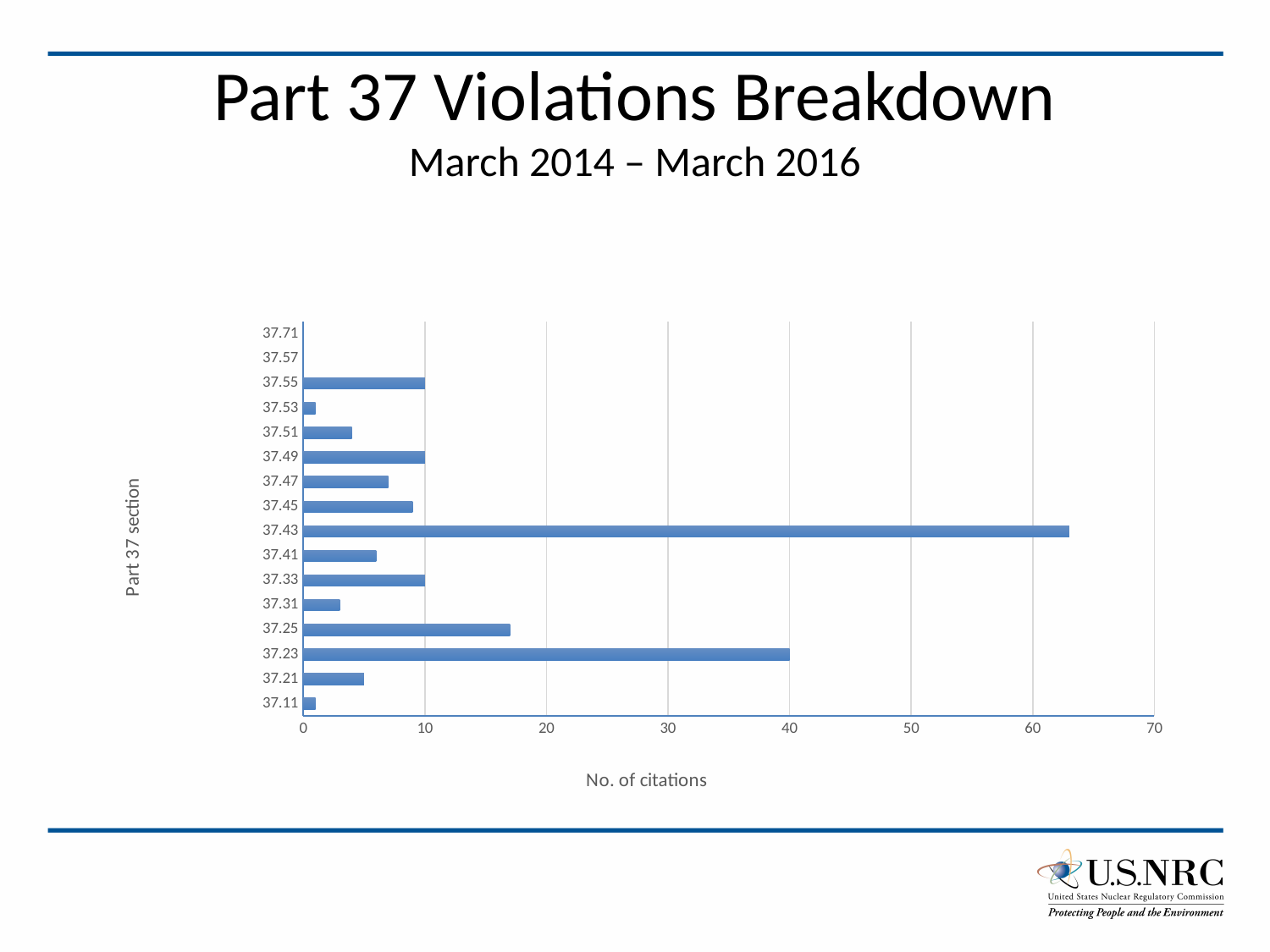
How many Part 37 sections are listed on the y axis of the chart? 16 Is the number of citations for section 37.11 greater or less than 10? less Is the number of citations for section 37.25 greater or less than 10? greater Which section has more citations, 37.25 or 37.21? 37.25 Is the number of citations for section 37.47 greater or less than 10? less How many citations are shown for section 37.23? 40 How many citations are shown for section 37.55? 10 Which Part 37 section has the highest number of citations? 37.43 Which section has more citations, 37.43 or 37.23? 37.43 What is the title of the horizontal axis of the chart? No. of citations What kind of chart is shown on the slide? bar chart